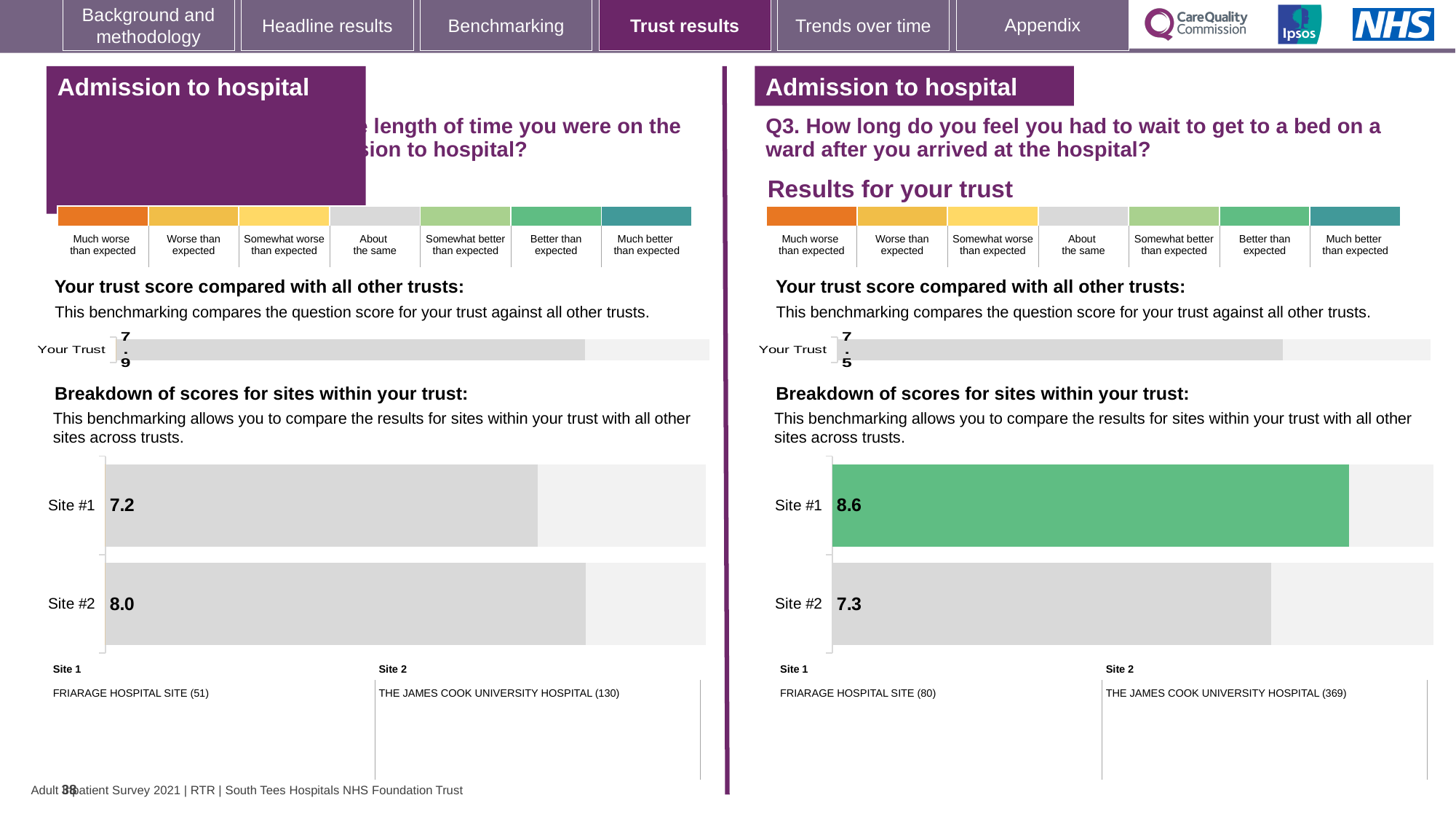
On the Q3 site breakdown chart (right panel), what is the score for Site #1? 8.6 On the left panel's site breakdown chart, what is the difference between the Site #2 and Site #1 scores? 0.8 What type of chart is used for the site breakdown on the right panel? Bar chart On the Q3 site breakdown chart (right panel), which site has the higher score? Site #1 On the Q3 site breakdown chart (right panel), what is the difference between the Site #1 and Site #2 scores? 1.3 On the left panel's 'Your trust score compared with all other trusts' chart, what is the score for Your Trust? 7.9 On the Q3 'Your trust score compared with all other trusts' chart (right panel), what is the score for Your Trust? 7.5 On the Q3 site breakdown chart (right panel), what is the score for Site #2? 7.3 On the left panel's site breakdown chart, what is the score for Site #1? 7.2 On the left panel's site breakdown chart, which site has the lower score? Site #1 On the left panel's site breakdown chart, what is the score for Site #2? 8.0 How many sites are shown on the Q3 site breakdown chart (right panel)? 2